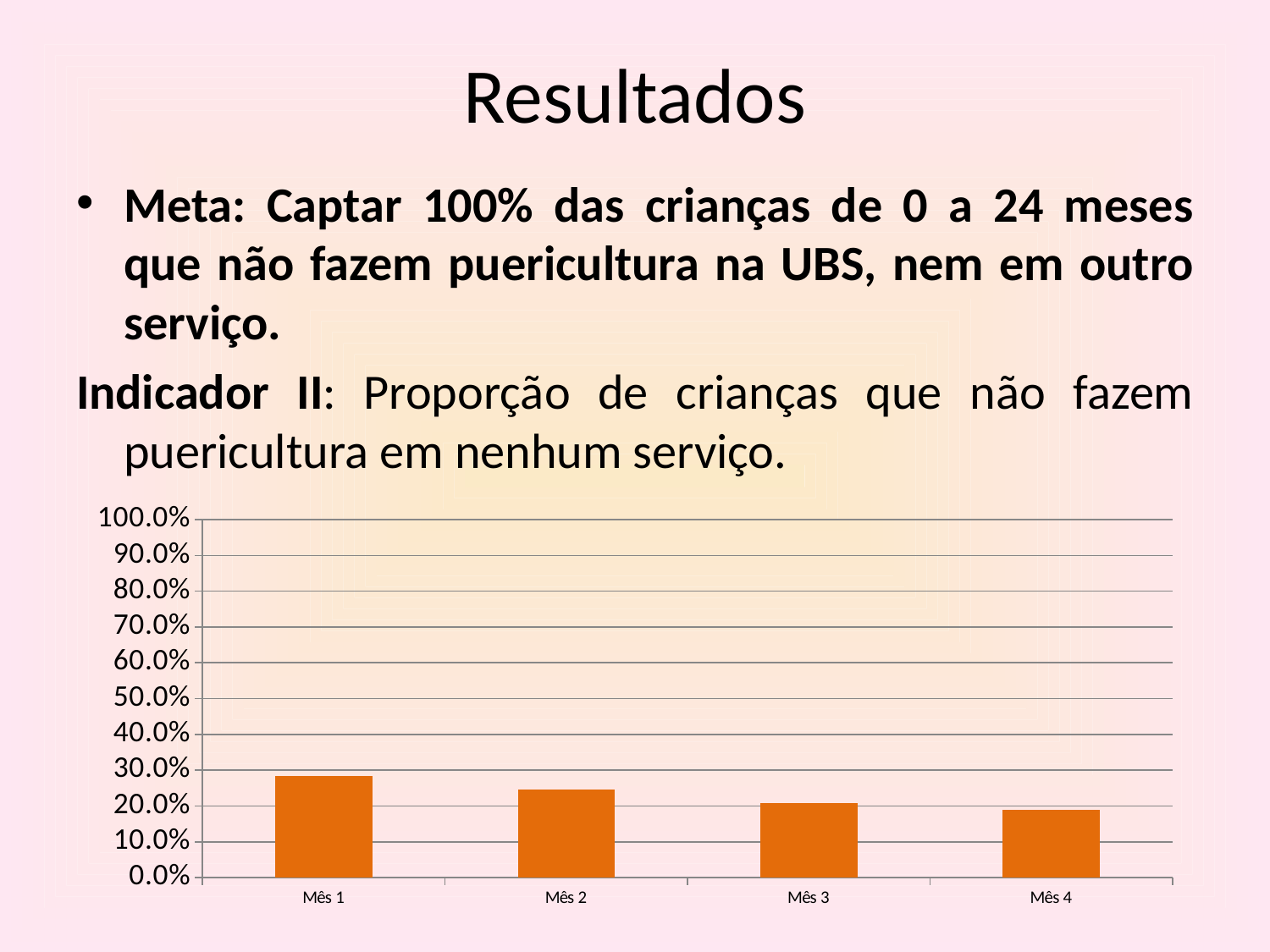
What is the highest value shown on the chart's vertical axis? 100.0% Is the value for Mês 4 greater or less than 10.0%? greater Which is larger, the value for Mês 1 or the value for Mês 2? Mês 1 Which is larger, the value for Mês 1 or the value for Mês 4? Mês 1 Is the value for Mês 1 greater or less than 20.0%? greater How many categories (months) are plotted on the chart? 4 Is the value for Mês 2 greater or less than 30.0%? less Which month has the highest bar? Mês 1 Which month has the lowest bar? Mês 4 Do the values rise or fall from Mês 1 to Mês 4? fall What kind of chart is shown on the slide? bar chart